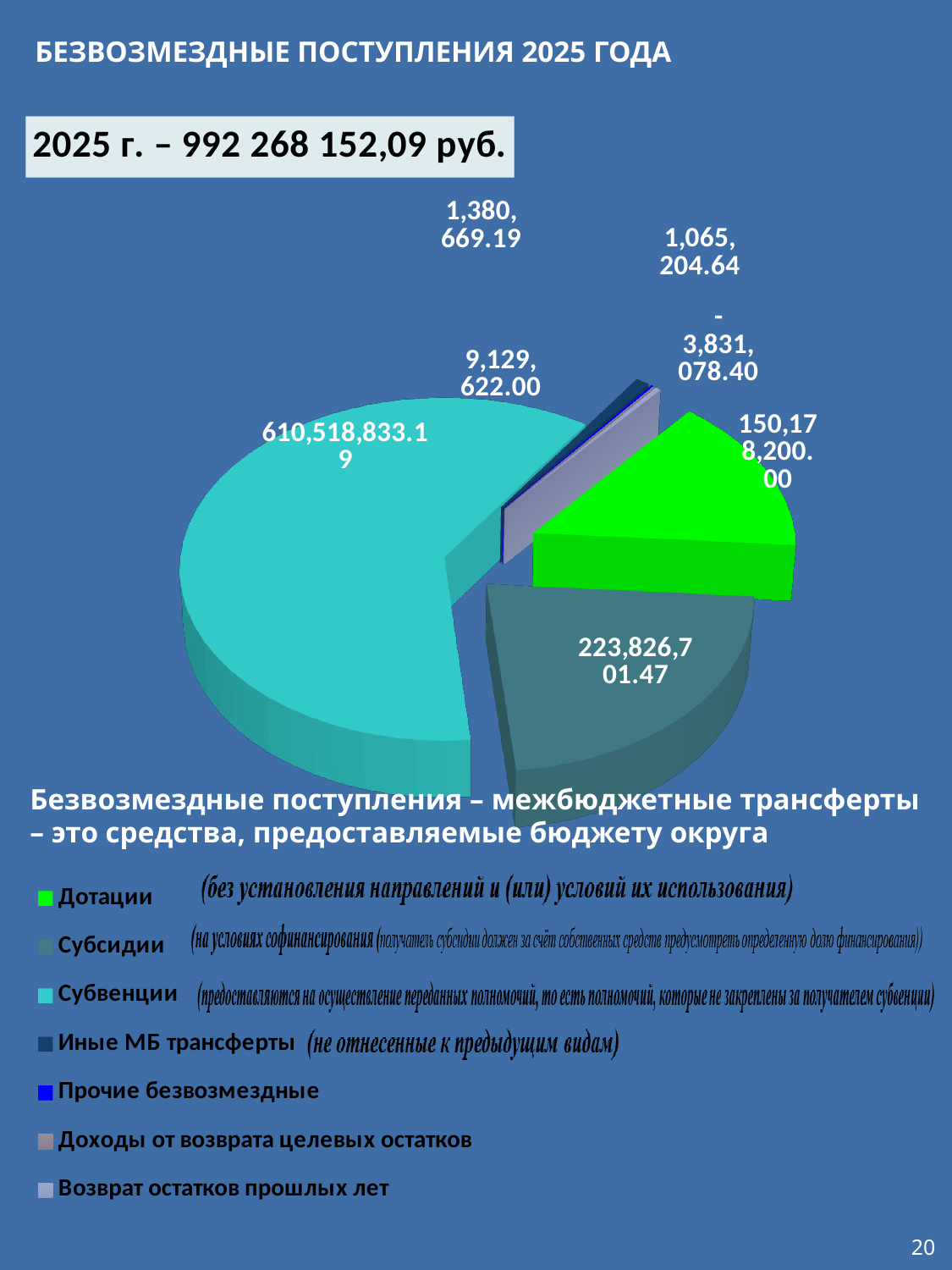
How many categories does the legend of the pie chart list? 7 What colour represents Дотации in the pie chart legend? green What is the difference between the values for Субвенции and Субсидии? 386,692,131.72 What kind of chart is shown on the slide? pie chart What is the difference between the values for Субсидии and Дотации? 73,648,501.47 What total amount for 2025 is stated in the box above the chart? 992 268 152,09 руб. Which category has the largest slice in the pie chart? Субвенции What is the value shown for Дотации in the pie chart? 150,178,200.00 What is the value shown for Субсидии in the pie chart? 223,826,701.47 What is the smallest value labelled on the pie chart? -3,831,078.40 What is the value shown for Субвенции in the pie chart? 610,518,833.19 Which is larger in the pie chart, Субсидии or Дотации? Субсидии